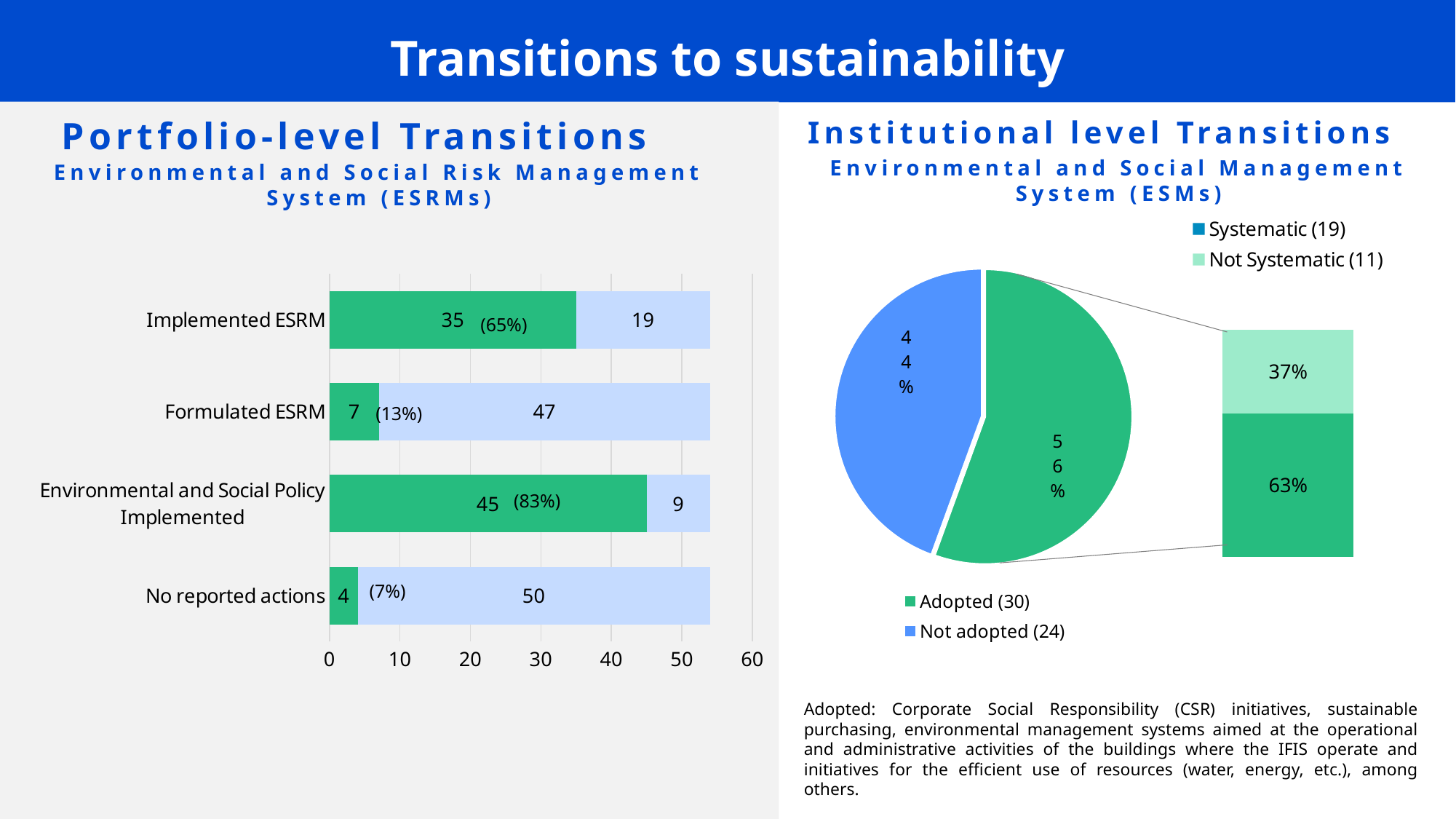
In the Portfolio-level Transitions bar chart, what is the light blue value for Formulated ESRM? 47 In the Portfolio-level Transitions bar chart, what is the total of the stacked bar for No reported actions? 54 In the Institutional level Transitions chart, what percentage is shown for the Systematic portion of the Adopted breakdown? 63% In the Portfolio-level Transitions bar chart, which category has the highest green value? Environmental and Social Policy Implemented What type of chart is the Portfolio-level Transitions chart? Stacked bar chart In the Portfolio-level Transitions bar chart, what percentage is shown next to Environmental and Social Policy Implemented? (83%) In the Portfolio-level Transitions bar chart, which category has the lowest green value? No reported actions In the Portfolio-level Transitions bar chart, what is the difference between the green value for Implemented ESRM and the green value for Formulated ESRM? 28 In the Portfolio-level Transitions bar chart, how many categories are shown? 4 In the Institutional level Transitions pie chart, what share does Adopted (30) have? 56% In the Institutional level Transitions chart, which is larger, Adopted or Not adopted? Adopted In the Portfolio-level Transitions bar chart, what is the green value for Implemented ESRM? 35